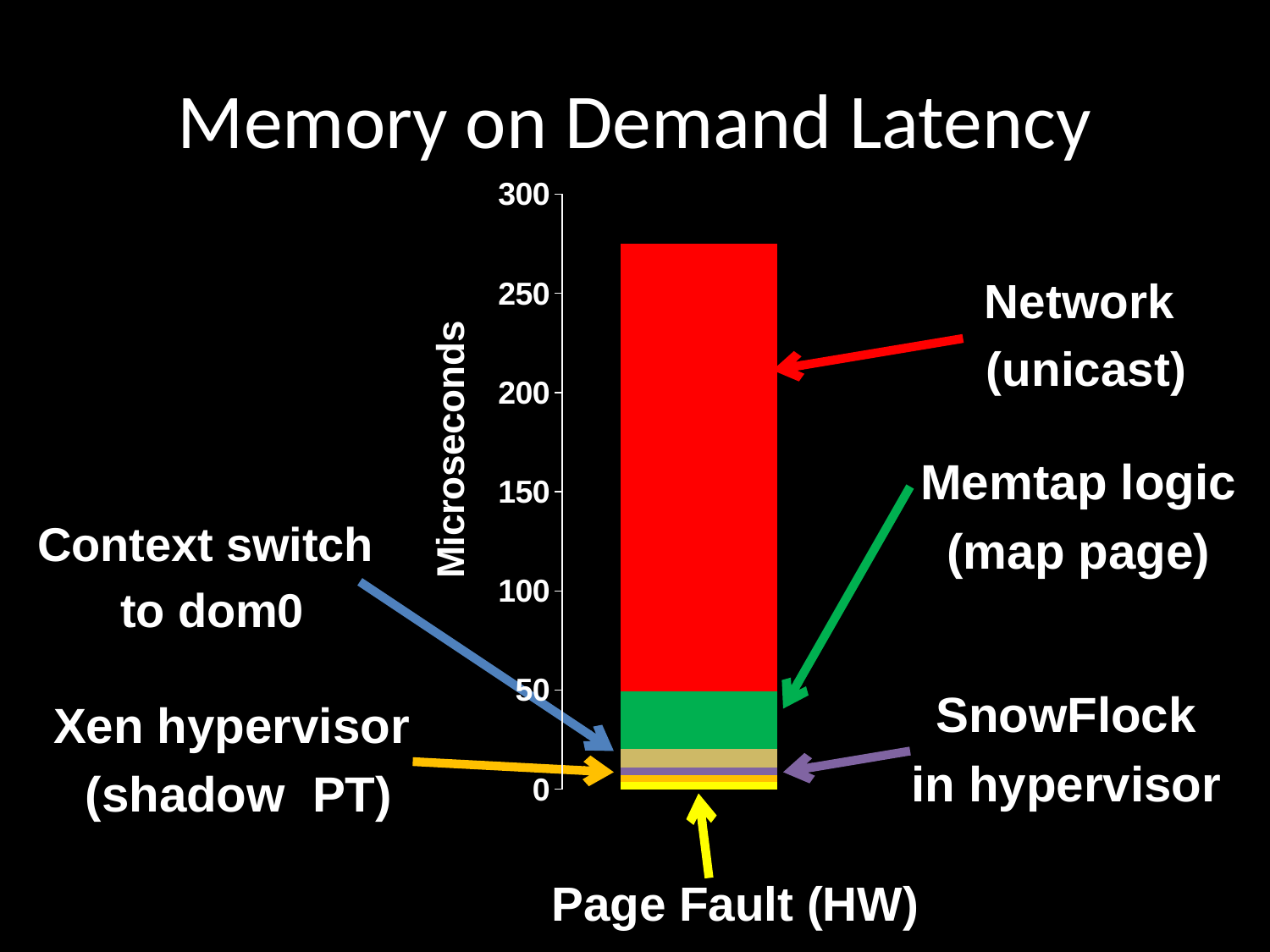
What kind of chart is shown on the slide? Stacked bar chart Which segment of the stacked bar is the largest? Network (unicast) Is the combined height of all segments below Network (unicast) greater or less than 100 microseconds? less Is the Network (unicast) segment greater or less than 200 microseconds? greater Which is larger, the Network (unicast) segment or the Memtap logic (map page) segment? Network (unicast) How many labelled segments make up the stacked bar? 6 Is the total height of the stacked bar greater or less than 250 microseconds? greater What unit is shown on the vertical axis of the chart? Microseconds What is the title of the chart? Memory on Demand Latency Which is larger, the Memtap logic (map page) segment or the Page Fault (HW) segment? Memtap logic (map page)